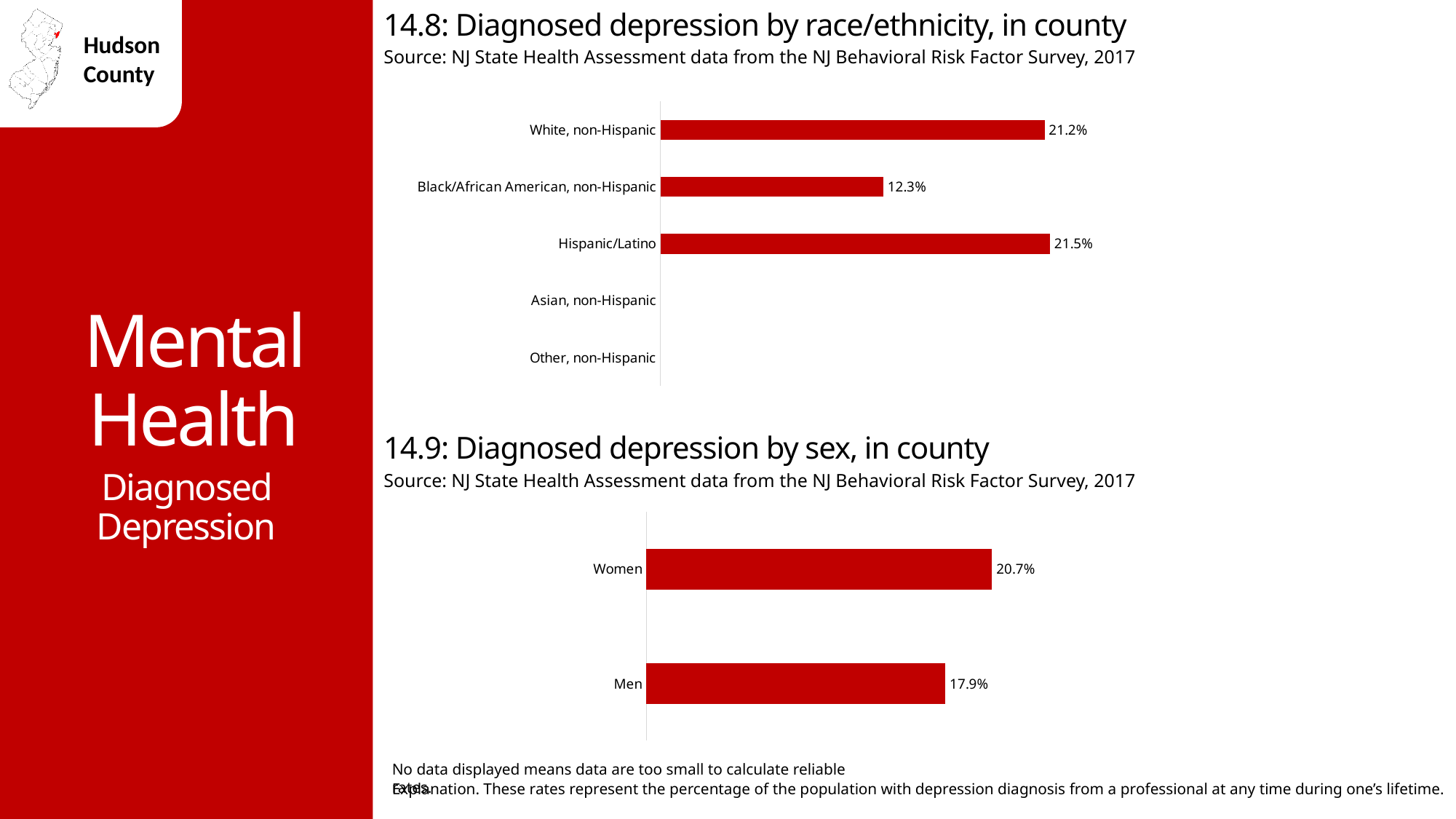
In the chart '14.8: Diagnosed depression by race/ethnicity, in county', which category has the lowest value among those with a bar shown? Black/African American, non-Hispanic In the chart '14.8: Diagnosed depression by race/ethnicity, in county', which categories have no bar displayed? Asian, non-Hispanic and Other, non-Hispanic In the chart '14.8: Diagnosed depression by race/ethnicity, in county', what is the value for Hispanic/Latino? 21.5% In the chart '14.8: Diagnosed depression by race/ethnicity, in county', what is the difference between the values for Hispanic/Latino and Black/African American, non-Hispanic? 9.2% What kind of chart is '14.9: Diagnosed depression by sex, in county'? Bar chart In the chart '14.8: Diagnosed depression by race/ethnicity, in county', how many categories are listed on the axis? 5 In the chart '14.8: Diagnosed depression by race/ethnicity, in county', what is the value for Black/African American, non-Hispanic? 12.3% In the chart '14.9: Diagnosed depression by sex, in county', what is the value for Men? 17.9% In the chart '14.9: Diagnosed depression by sex, in county', what is the difference between the values for Women and Men? 2.8% In the chart '14.8: Diagnosed depression by race/ethnicity, in county', what is the value for White, non-Hispanic? 21.2% In the chart '14.9: Diagnosed depression by sex, in county', what is the value for Women? 20.7% In the chart '14.9: Diagnosed depression by sex, in county', which category has the higher value, Women or Men? Women